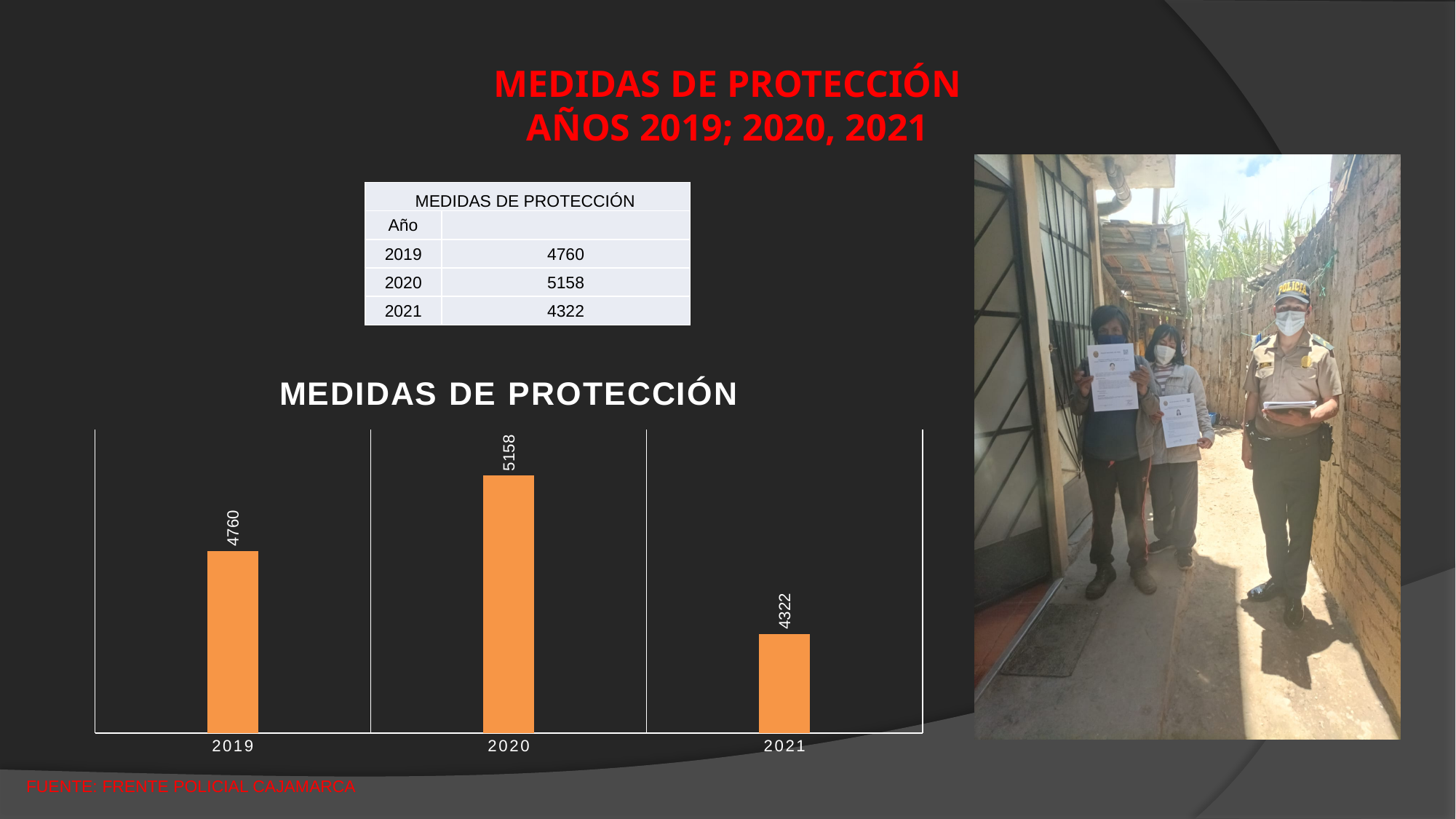
What is the title of the chart? MEDIDAS DE PROTECCIÓN Which year has the highest value in the chart? 2020 What is the difference between the values for 2020 and 2019? 398 What is the difference between the values for 2019 and 2021? 438 Which year has the lowest value in the chart? 2021 Which is larger, the value for 2019 or the value for 2021? 2019 How many years are shown in the chart? 3 What is the value for 2021 in the chart? 4322 What is the value for 2019 in the chart? 4760 Does the value rise or fall from 2020 to 2021? fall What kind of chart is shown on the slide? bar chart What is the value for 2020 in the chart? 5158